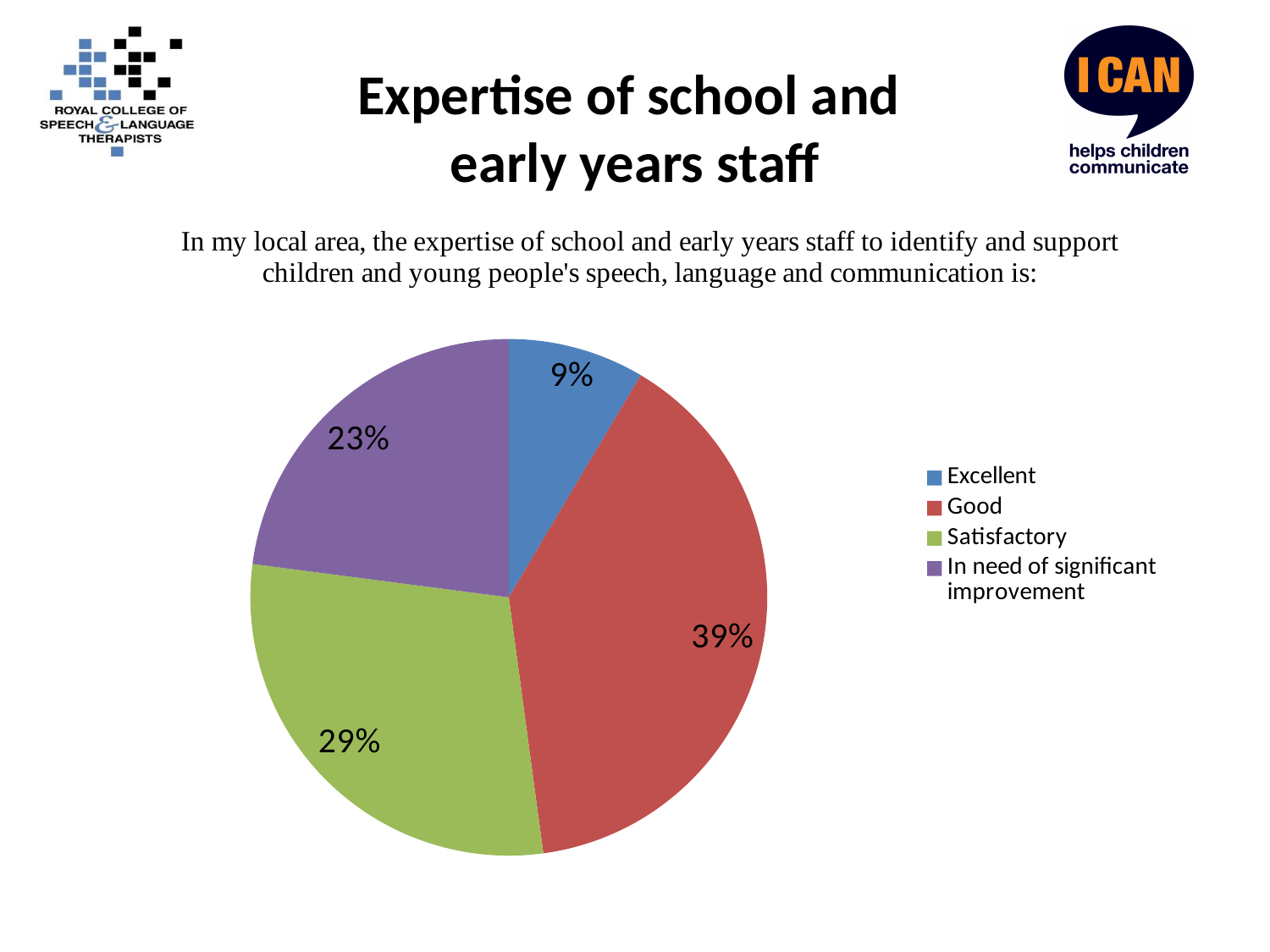
What is the combined share of the Excellent and Good slices? 48% Which category has the largest share of the pie? Good What kind of chart is shown on the slide? pie chart What percentage of respondents rated the expertise as Excellent? 9% What percentage of respondents rated the expertise as Satisfactory? 29% What is the difference in percentage points between the Good and Satisfactory slices? 10 Which category has the smallest share of the pie? Excellent What percentage of respondents said the expertise is in need of significant improvement? 23% What colour is the Good slice? red Which slice is larger, Satisfactory or In need of significant improvement? Satisfactory What percentage of respondents rated the expertise as Good? 39% How many categories does the legend list? 4